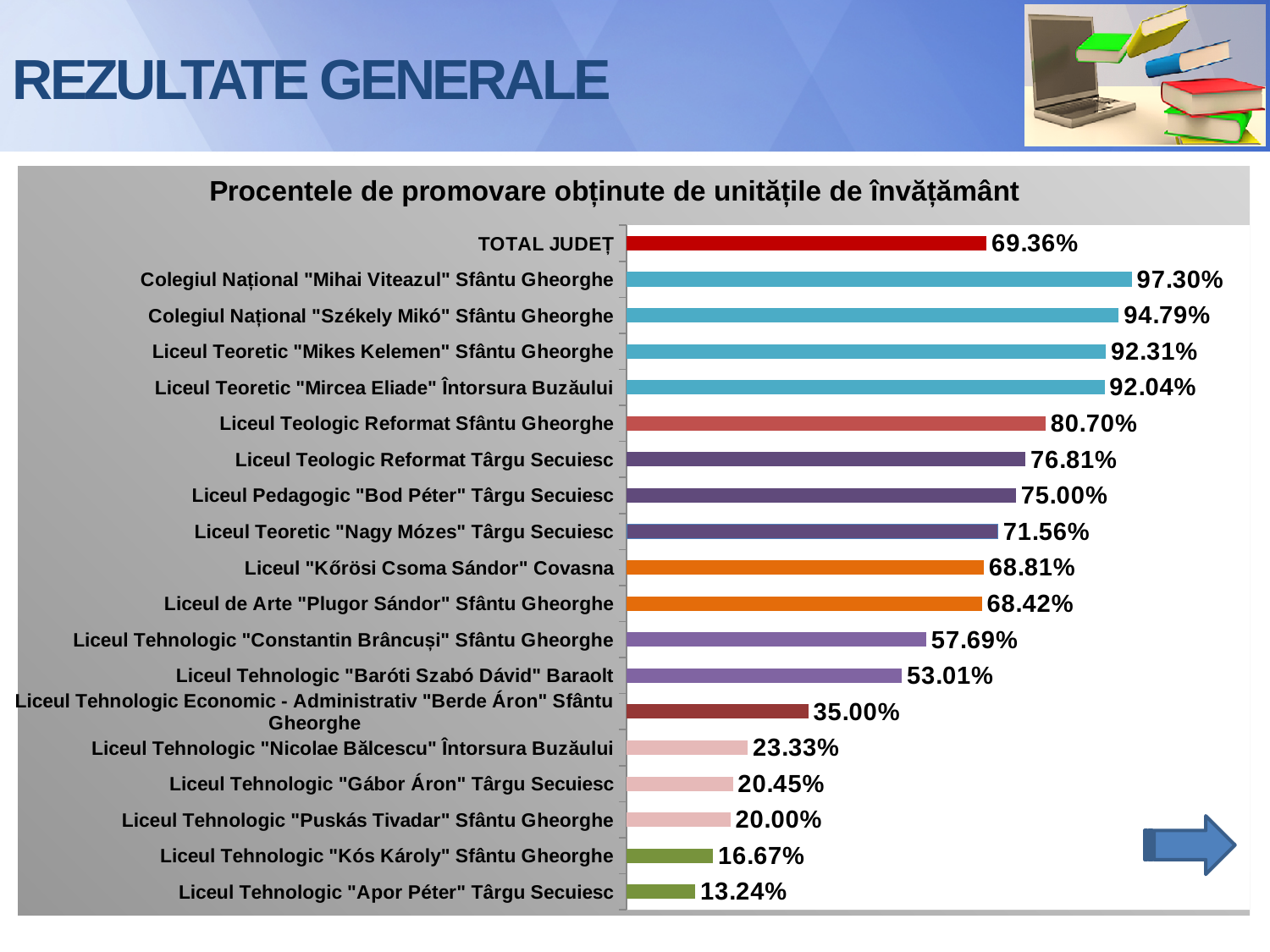
Which category has the lowest value? Liceul Tehnologic "Apor Péter" Târgu Secuiesc What kind of chart is shown on the slide? Bar chart What is the difference between the values for Liceul Teologic Reformat Sfântu Gheorghe and Liceul Teologic Reformat Târgu Secuiesc? 3.89% Which category has the highest value? Colegiul Național "Mihai Viteazul" Sfântu Gheorghe What is the title of the chart? Procentele de promovare obținute de unitățile de învățământ What is the value for Liceul Tehnologic Economic - Administrativ "Berde Áron" Sfântu Gheorghe? 35.00% Which is larger, the value for Liceul Pedagogic "Bod Péter" Târgu Secuiesc or the value for Liceul Teoretic "Nagy Mózes" Târgu Secuiesc? Liceul Pedagogic "Bod Péter" Târgu Secuiesc What is the value for TOTAL JUDEȚ? 69.36% How many bars does the chart show? 19 What is the difference between the values for Colegiul Național "Mihai Viteazul" Sfântu Gheorghe and Liceul Tehnologic "Apor Péter" Târgu Secuiesc? 84.06% What is the value for Colegiul Național "Székely Mikó" Sfântu Gheorghe? 94.79% What is the value for Liceul Tehnologic "Baróti Szabó Dávid" Baraolt? 53.01%